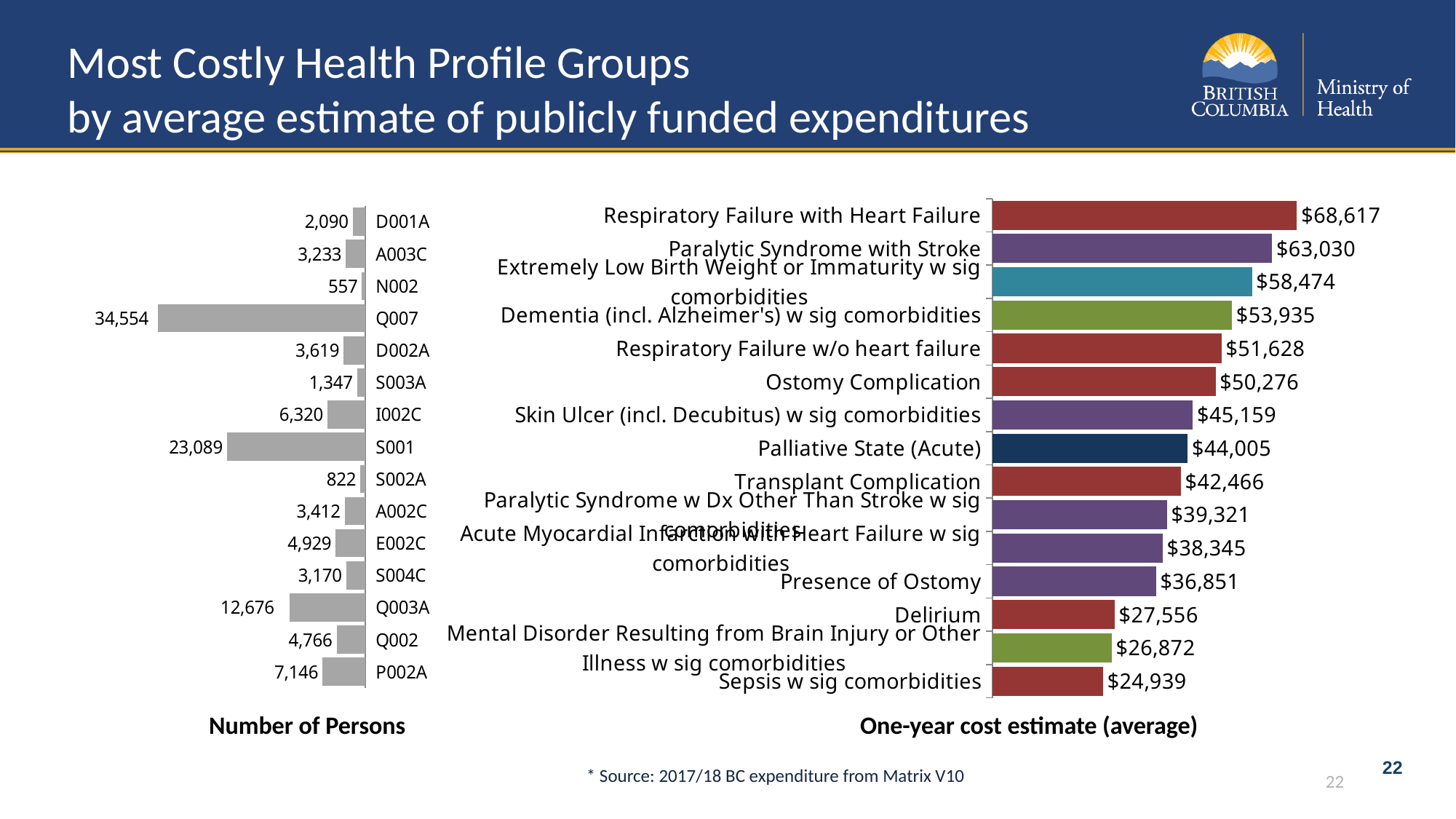
In the 'Number of Persons' chart, which code has the smallest number of persons? N002 In the 'Number of Persons' chart, which code has the largest number of persons? Q007 In the 'One-year cost estimate (average)' chart, which category has the lowest value? Sepsis w sig comorbidities In the 'Number of Persons' chart, what is the difference between Q007 and S001? 11,465 In the 'One-year cost estimate (average)' chart, which category has the highest value? Respiratory Failure with Heart Failure In the 'One-year cost estimate (average)' chart, what is the difference between Respiratory Failure with Heart Failure and Paralytic Syndrome with Stroke? $5,587 How many categories are shown in the 'One-year cost estimate (average)' chart? 15 What kind of chart is the 'One-year cost estimate (average)' chart? Bar chart In the 'Number of Persons' chart, which is larger: S001 or Q003A? S001 In the 'One-year cost estimate (average)' chart, do the values rise or fall going from the top bar to the bottom bar? Fall In the 'One-year cost estimate (average)' chart, what is the value for Palliative State (Acute)? $44,005 In the 'Number of Persons' chart, what is the value for Q003A? 12,676